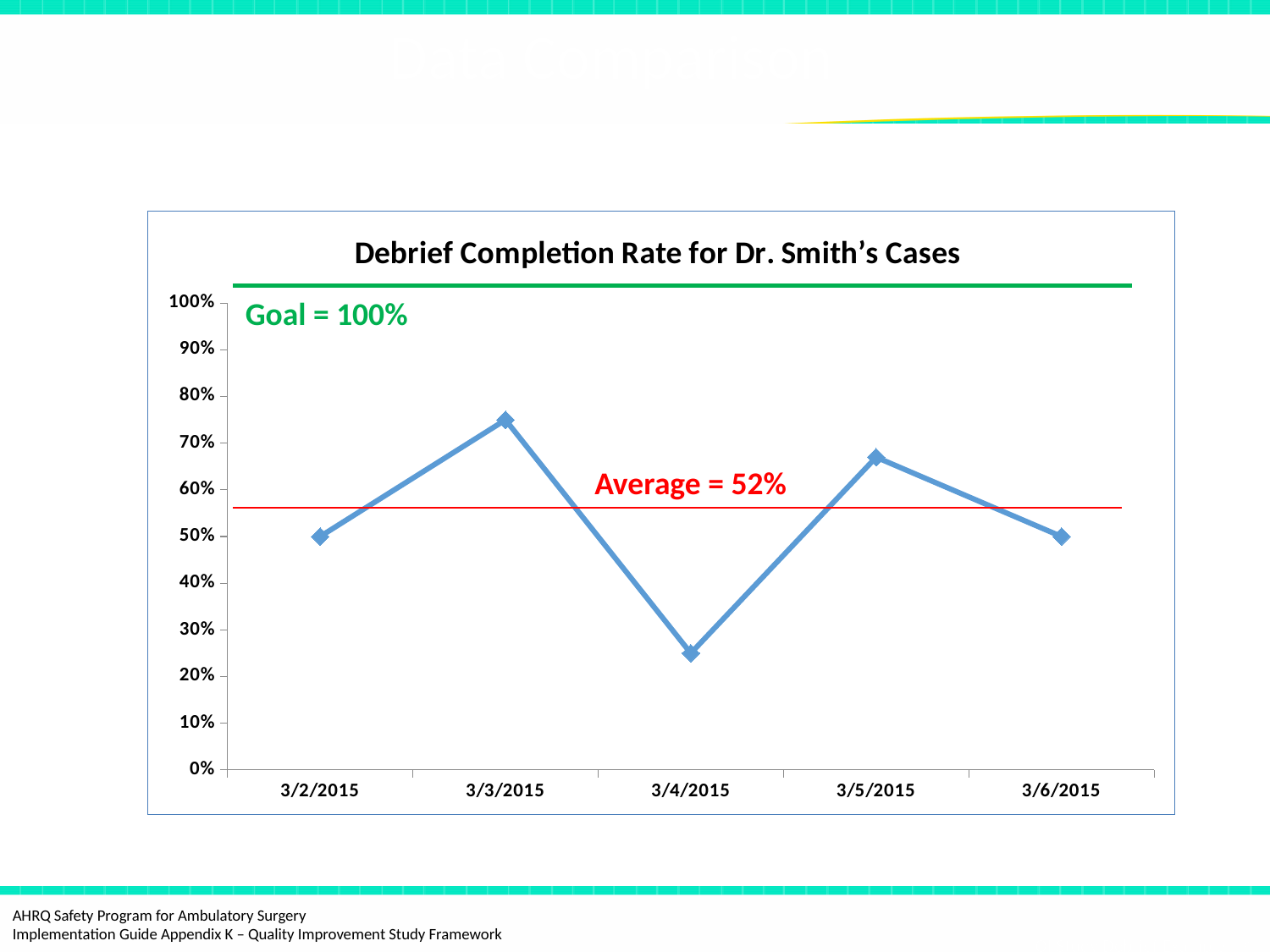
What kind of chart is shown on the slide? line chart Which date has a higher completion rate, 3/3/2015 or 3/5/2015? 3/3/2015 What is the debrief completion rate on 3/6/2015? 50% Is the value for 3/4/2015 greater or less than 30%? less Is the value for 3/5/2015 greater or less than 60%? greater What is the title of the chart? Debrief Completion Rate for Dr. Smith's Cases What average value is labeled on the chart? Average = 52% On which date is the debrief completion rate lowest? 3/4/2015 How many dates are plotted on the x axis? 5 What is the debrief completion rate on 3/2/2015? 50% On which date is the debrief completion rate highest? 3/3/2015 Is the value for 3/3/2015 greater or less than 70%? greater